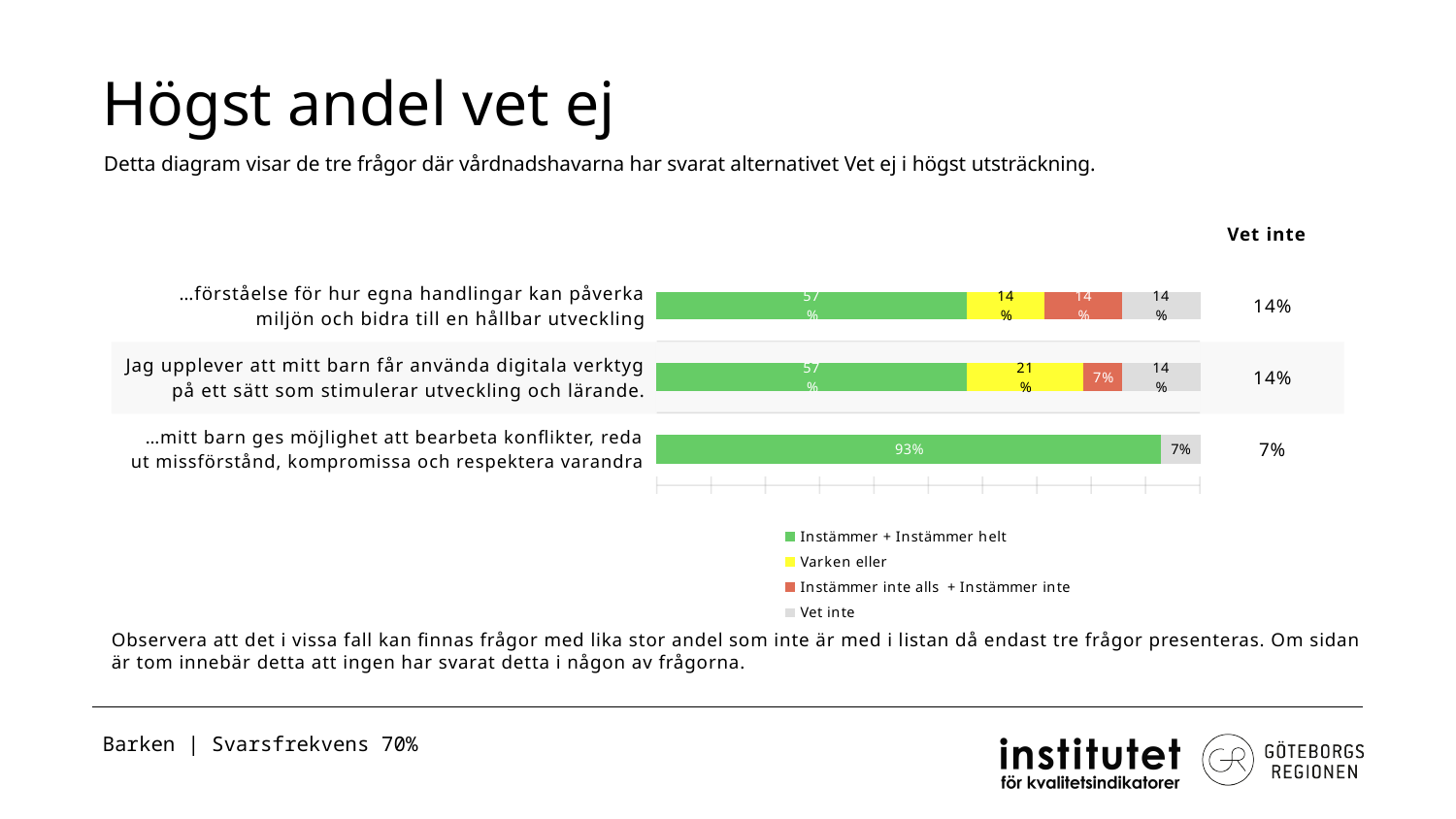
How many series does the legend list? 4 What is the title of the column to the right of the chart? Vet inte How many bars (questions) are shown in the chart? 3 What is the difference between the 'Varken eller' value of the middle bar and that of the top bar? 7% What is the 'Vet inte' value shown for the top bar ('…förståelse för hur egna handlingar kan påverka miljön…')? 14% What is the 'Instämmer inte alls + Instämmer inte' value for the middle bar? 7% Which bar has the lowest 'Vet inte' share? …mitt barn ges möjlighet att bearbeta konflikter, reda ut missförstånd, kompromissa och respektera varandra What is the 'Instämmer + Instämmer helt' value for the bottom bar ('…mitt barn ges möjlighet att bearbeta konflikter…')? 93% Which bar has the highest 'Instämmer + Instämmer helt' share? …mitt barn ges möjlighet att bearbeta konflikter, reda ut missförstånd, kompromissa och respektera varandra What kind of chart is shown on the slide? bar chart What is the 'Varken eller' value for the middle bar ('Jag upplever att mitt barn får använda digitala verktyg…')? 21% Which is larger: the 'Instämmer inte alls + Instämmer inte' value for the top bar or for the middle bar? the top bar